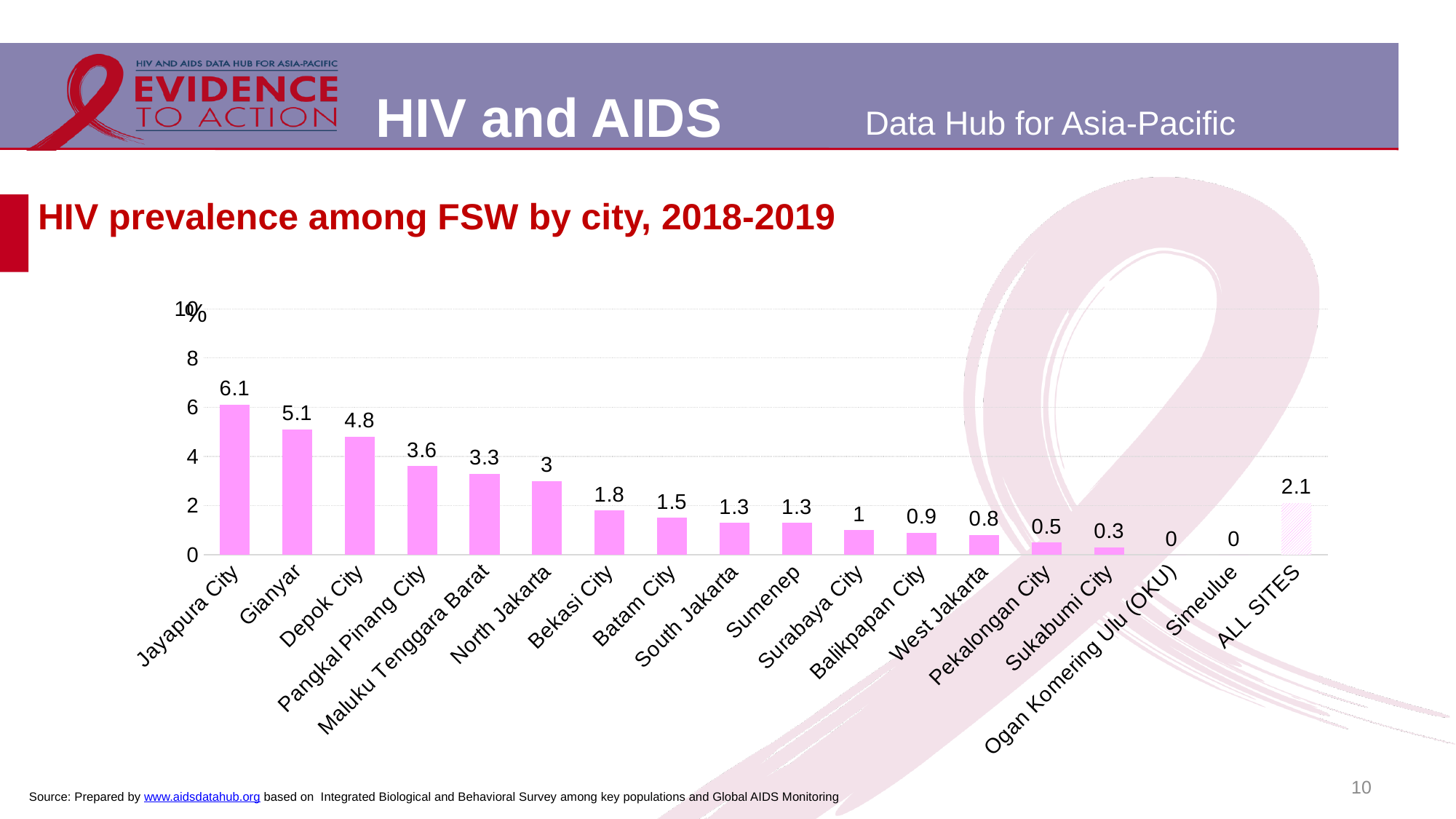
What is the HIV prevalence among FSW in Pangkal Pinang City? 3.6 Which city has the highest HIV prevalence among FSW on the chart? Jayapura City What is the HIV prevalence among FSW in Jayapura City? 6.1 What is the value shown for ALL SITES? 2.1 What type of chart is shown on the slide? Bar chart Which cities show a value of 0 on the chart? Ogan Komering Ulu (OKU) and Simeulue What is the title of the chart on the slide? HIV prevalence among FSW by city, 2018-2019 Which has a higher value, Bekasi City or Batam City? Bekasi City What is the difference between the values for Jayapura City and Gianyar? 1 How many bars are plotted on the chart, including ALL SITES? 18 What is the value shown for Sukabumi City? 0.3 What is the difference between the values for Depok City and North Jakarta? 1.8